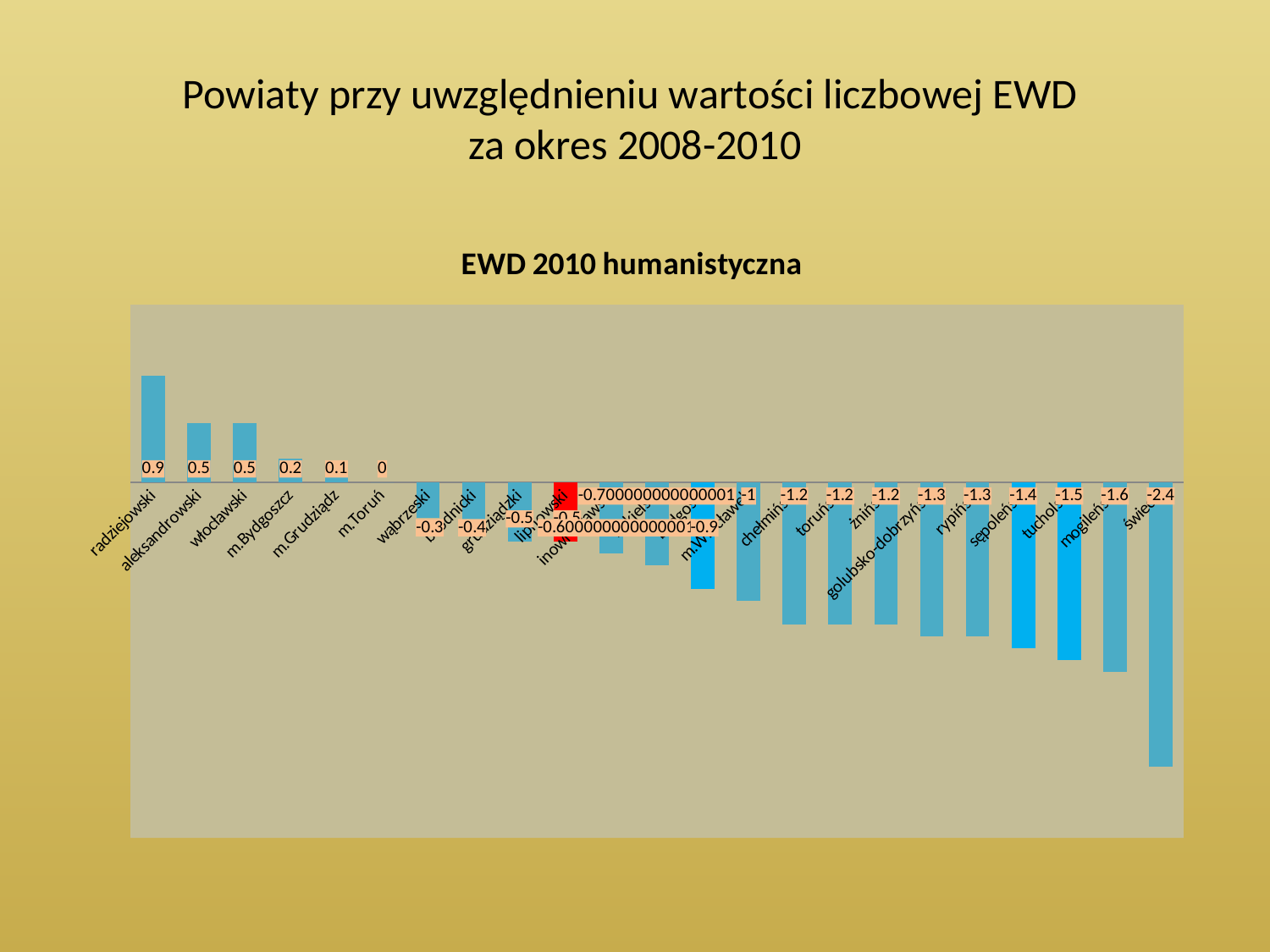
What is the title of the chart? EWD 2010 humanistyczna Which category has the highest value? radziejowski What is the value for mogileński? -1.6 Which has a larger value, m.Bydgoszcz or m.Grudziądz? m.Bydgoszcz What is the value for radziejowski? 0.9 What is the value for sępoleński? -1.4 What is the value for m.Toruń? 0 What is the value for tucholski? -1.5 What type of chart is shown on the slide? bar chart Do the values rise or fall from left to right along the x axis? fall What is the difference between the values for radziejowski and aleksandrowski? 0.4 What is the lowest value shown in the chart? -2.4